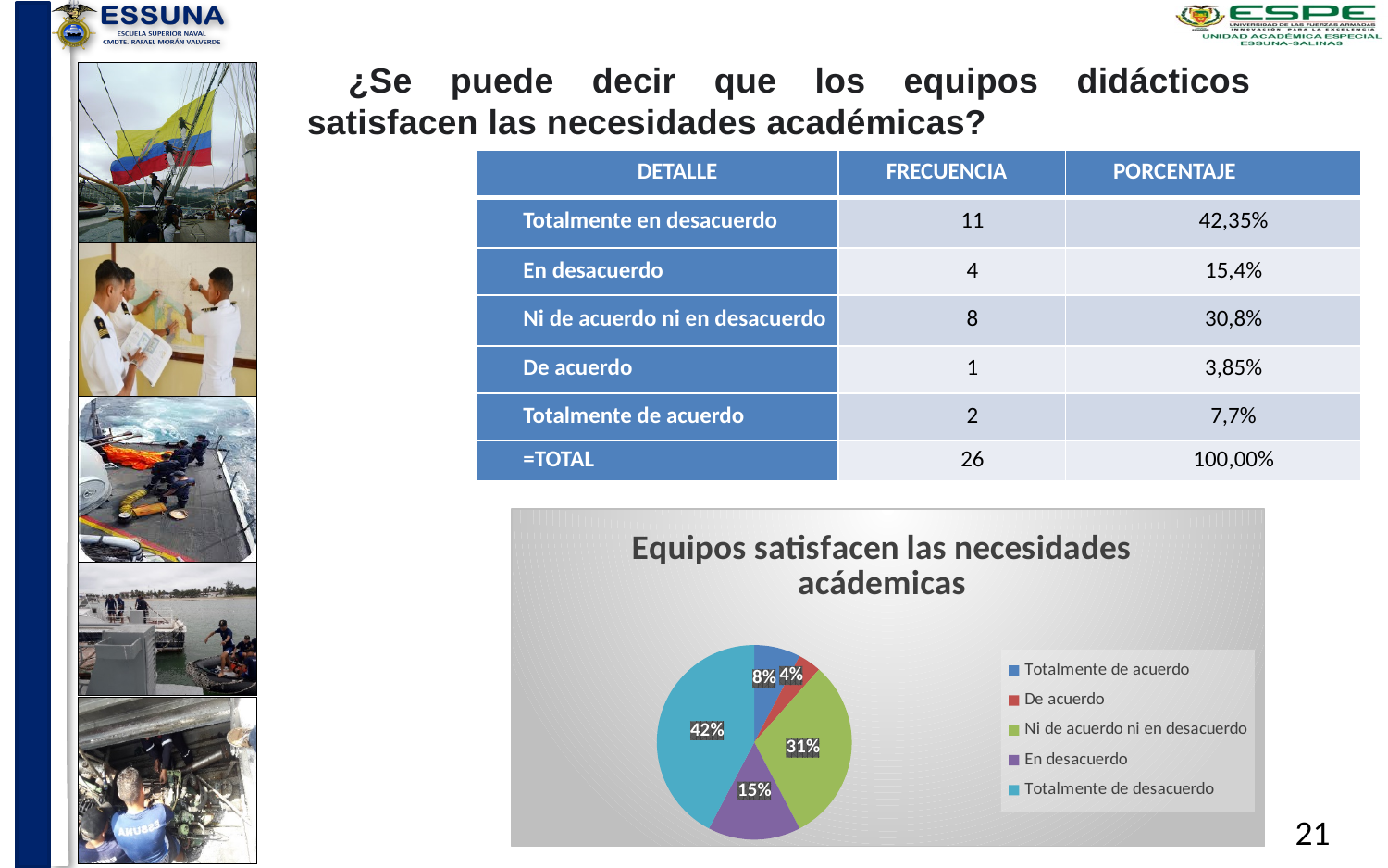
What percentage does the 'Ni de acuerdo ni en desacuerdo' slice show? 31% How many entries does the chart legend list? 5 What kind of chart is shown on the slide? pie chart What percentage does the 'Totalmente de desacuerdo' slice show? 42% What percentage does the 'En desacuerdo' slice show? 15% Which slice is larger, 'Totalmente de acuerdo' or 'En desacuerdo'? En desacuerdo What is the title of the chart? Equipos satisfacen las necesidades acádemicas How many slices does the pie chart have? 5 What percentage does the 'De acuerdo' slice show? 4% Which category has the smallest slice of the pie? De acuerdo What is the difference in percentage points between the 'Totalmente de desacuerdo' slice and the 'Ni de acuerdo ni en desacuerdo' slice? 11 Which category has the largest slice of the pie? Totalmente de desacuerdo